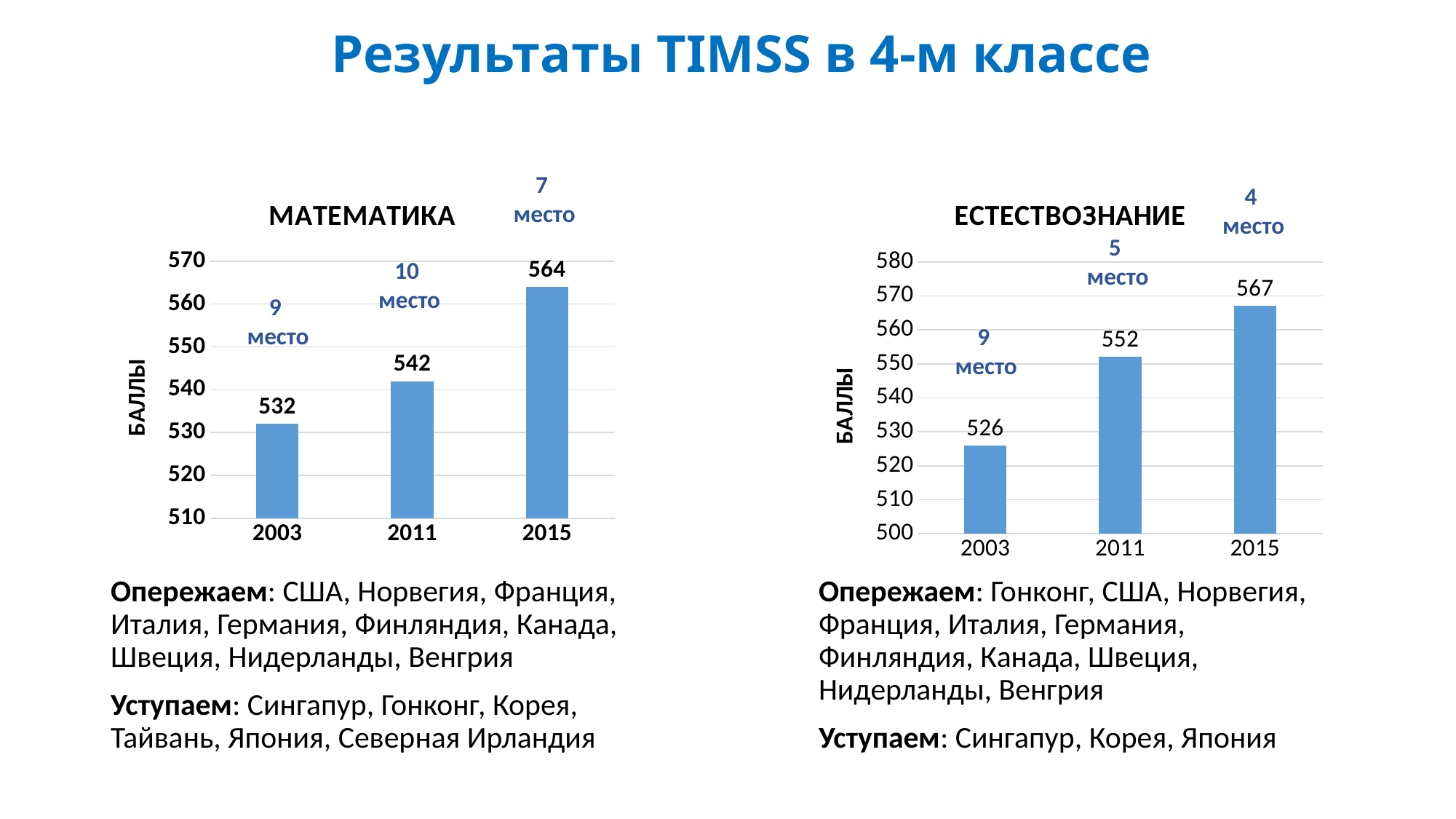
How many years are shown in the МАТЕМАТИКА chart? 3 In the МАТЕМАТИКА chart, which year has the highest value? 2015 In the ЕСТЕСТВОЗНАНИЕ chart, which year has the lowest value? 2003 In the ЕСТЕСТВОЗНАНИЕ chart, what is the value for 2011? 552 In the ЕСТЕСТВОЗНАНИЕ chart, which is larger, the value for 2011 or the value for 2015? 2015 What kind of chart is the ЕСТЕСТВОЗНАНИЕ chart? bar chart In the МАТЕМАТИКА chart, what is the value for 2015? 564 In the МАТЕМАТИКА chart, do the values rise or fall from 2003 to 2015? rise In the ЕСТЕСТВОЗНАНИЕ chart, what is the value for 2003? 526 In the МАТЕМАТИКА chart, what is the difference between the values for 2015 and 2011? 22 In the ЕСТЕСТВОЗНАНИЕ chart, what is the difference between the values for 2015 and 2003? 41 In the МАТЕМАТИКА chart, what is the value for 2003? 532